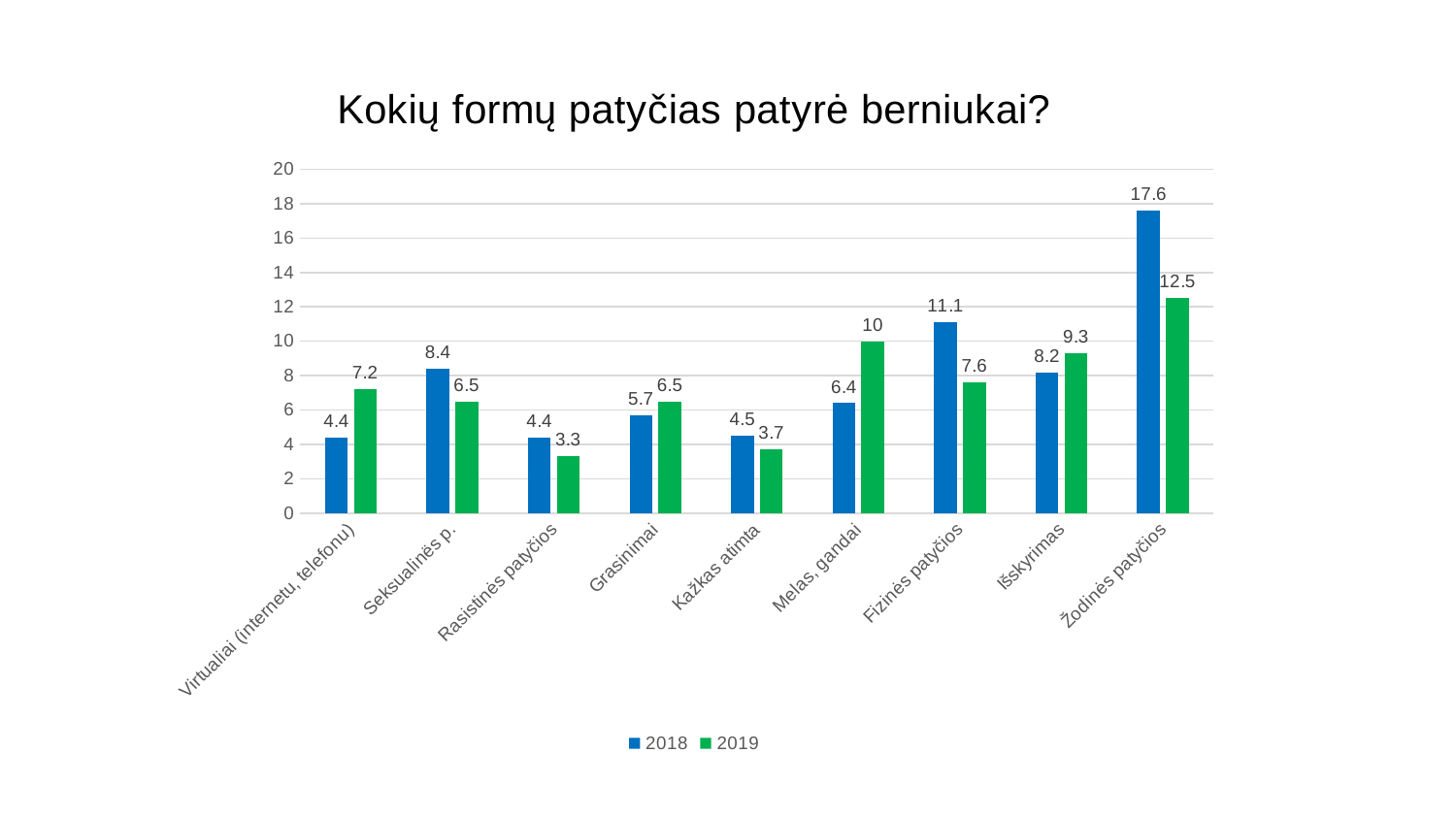
What is the difference between the 2018 and 2019 values for Žodinės patyčios? 5.1 Which category has the highest 2019 value? Žodinės patyčios How many series does the legend list? 2 What kind of chart is shown on the slide? Bar chart Which is larger for Fizinės patyčios, the 2018 value or the 2019 value? 2018 What is the 2019 value for Rasistinės patyčios? 3.3 How many categories are shown on the x axis? 9 What is the 2019 value for Melas, gandai? 10 Which is larger for Išskyrimas, the 2018 value or the 2019 value? 2019 What is the difference between the 2019 and 2018 values for Melas, gandai? 3.6 Which category has the lowest 2019 value? Rasistinės patyčios What is the 2018 value for Žodinės patyčios? 17.6